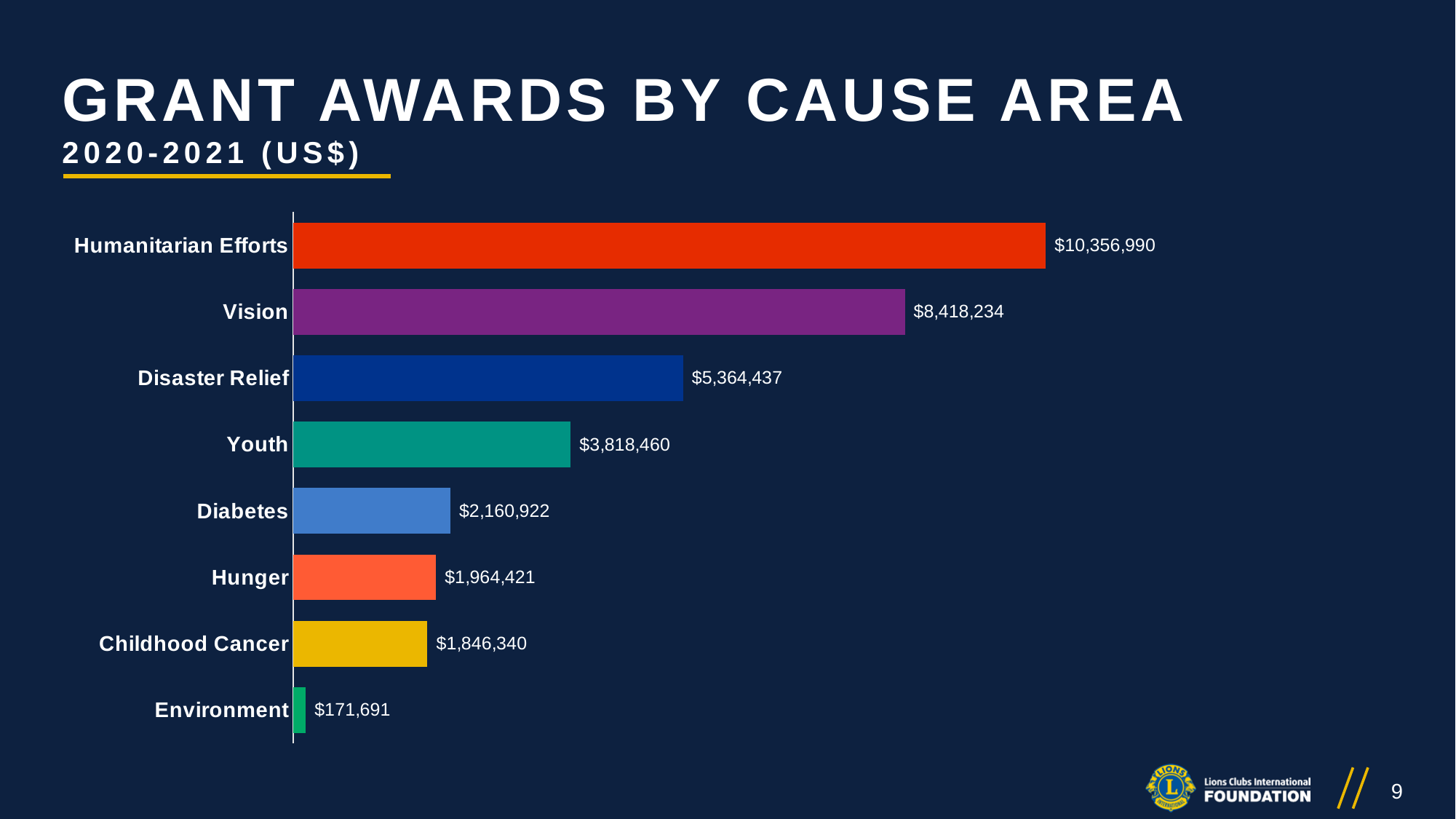
What is the grant award value for Environment? $171,691 What is the title of the chart on the slide? Grant Awards by Cause Area 2020-2021 (US$) Which received a larger grant award, Diabetes or Hunger? Diabetes How many cause areas are shown in the chart? 8 What is the difference between the grant awards for Humanitarian Efforts and Vision? $1,938,756 What kind of chart is shown on the slide? Bar chart Which cause area received the lowest grant award amount? Environment What is the difference between the grant awards for Hunger and Childhood Cancer? $118,081 What is the grant award value for Diabetes? $2,160,922 Which cause area received the highest grant award amount? Humanitarian Efforts What is the grant award value for Vision? $8,418,234 Which received a larger grant award, Disaster Relief or Youth? Disaster Relief